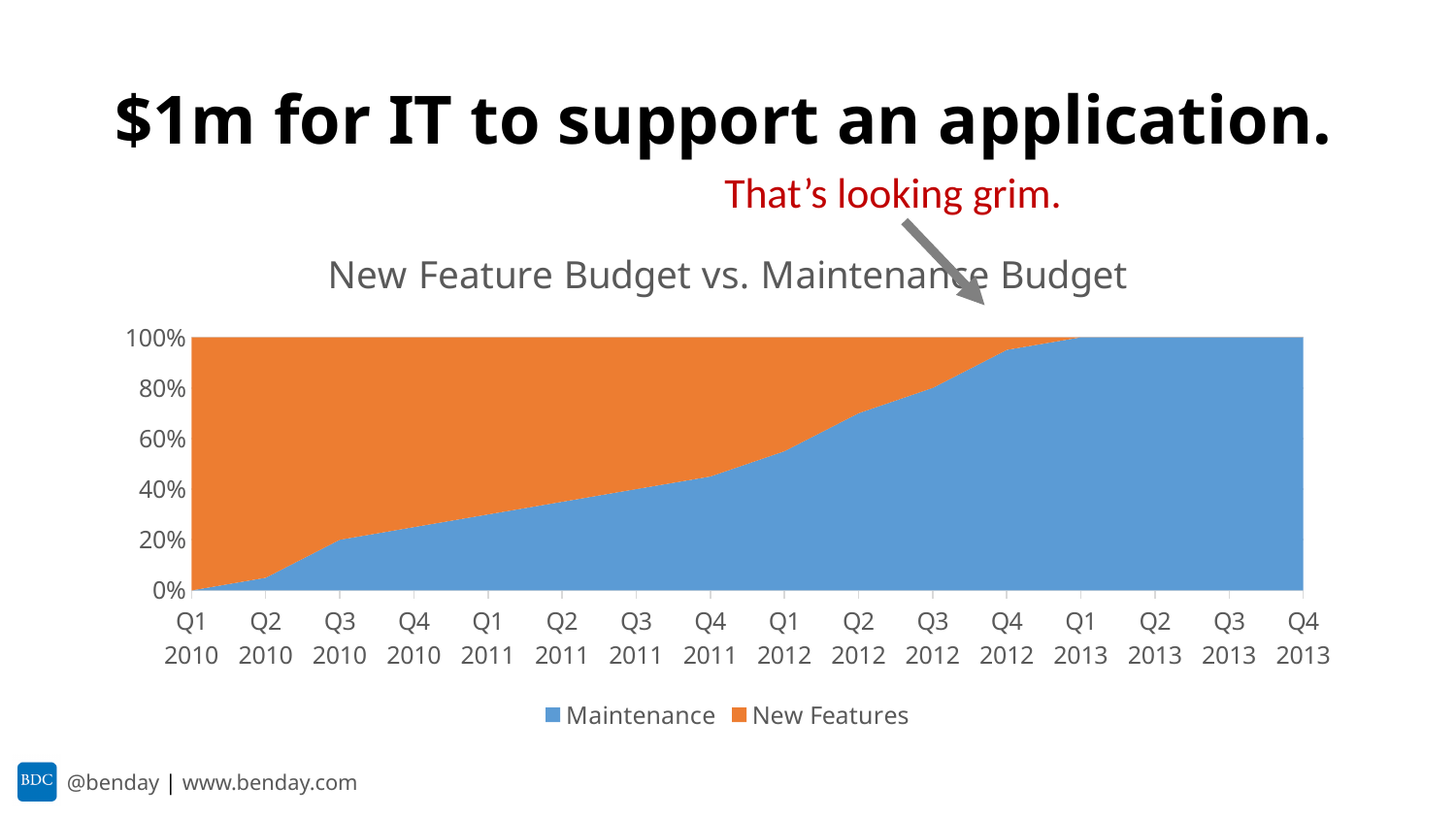
Is the Maintenance share in Q1 2010 greater or less than 20%? less Does the Maintenance share rise or fall from Q1 2010 to Q4 2013? Rise What is the title of the chart? New Feature Budget vs. Maintenance Budget In which quarter is the Maintenance share lowest? Q1 2010 How many series does the legend list? 2 In Q4 2013, which series has the larger share: Maintenance or New Features? Maintenance Which series is shown in blue? Maintenance Is the Maintenance share in Q4 2013 greater or less than 80%? greater How many quarters are shown along the x axis? 16 What kind of chart is shown on the slide? Area chart Is the Maintenance share in Q2 2012 greater or less than 60%? greater In Q1 2010, which series has the larger share: Maintenance or New Features? New Features